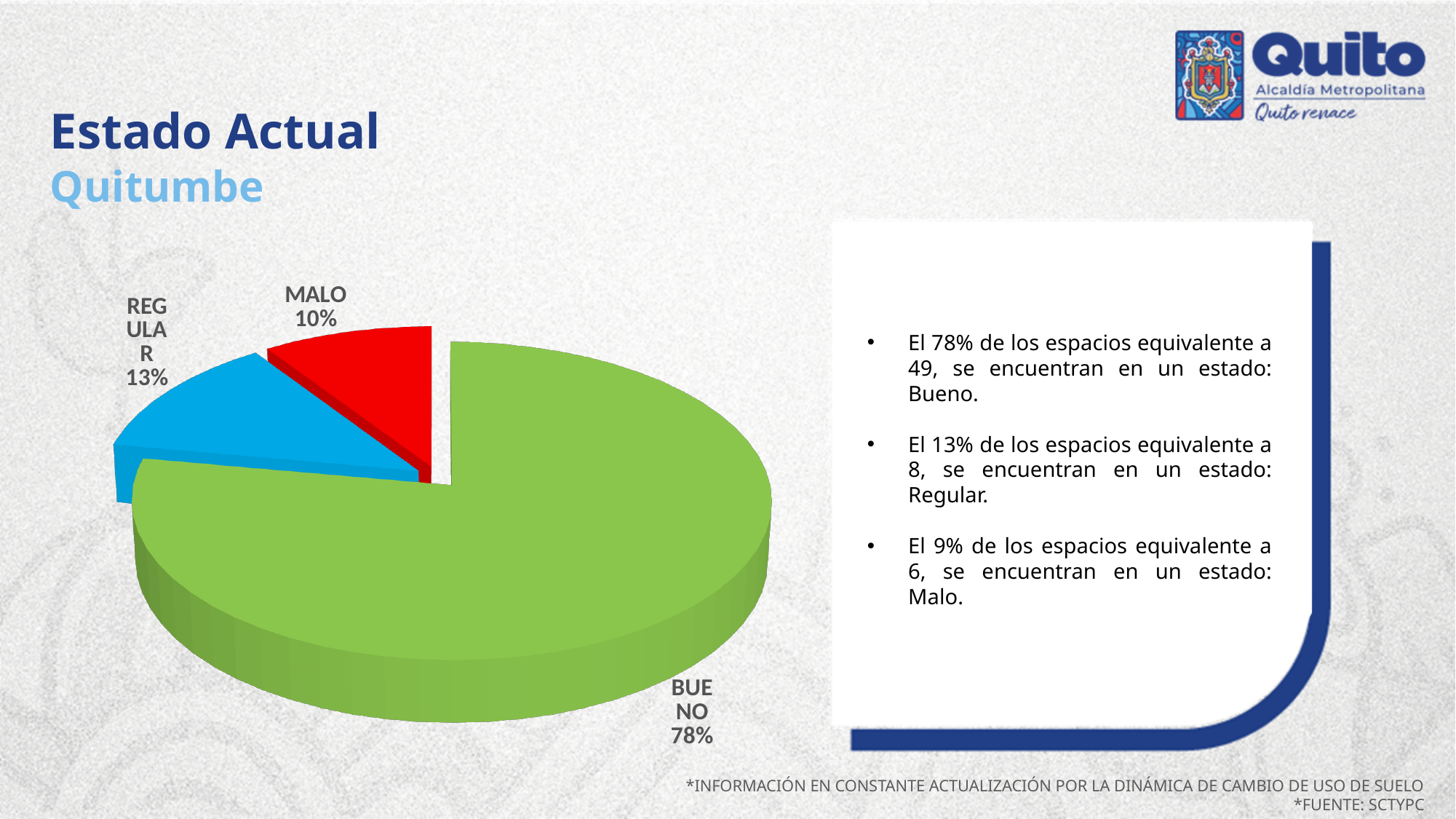
What colour is the BUENO slice in the pie chart? Green What percentage does the BUENO slice show in the pie chart? 78% Which slice is larger, REGULAR or MALO? REGULAR Which category has the largest slice in the pie chart? BUENO What is the difference in percentage points between the REGULAR and MALO slices? 3 What type of chart is shown on the slide? Pie chart Which category has the smallest slice in the pie chart? MALO What colour is the MALO slice in the pie chart? Red What percentage does the REGULAR slice show in the pie chart? 13% What is the difference in percentage points between the BUENO and REGULAR slices? 65 How many slices does the pie chart have? 3 What percentage does the MALO slice show in the pie chart? 10%